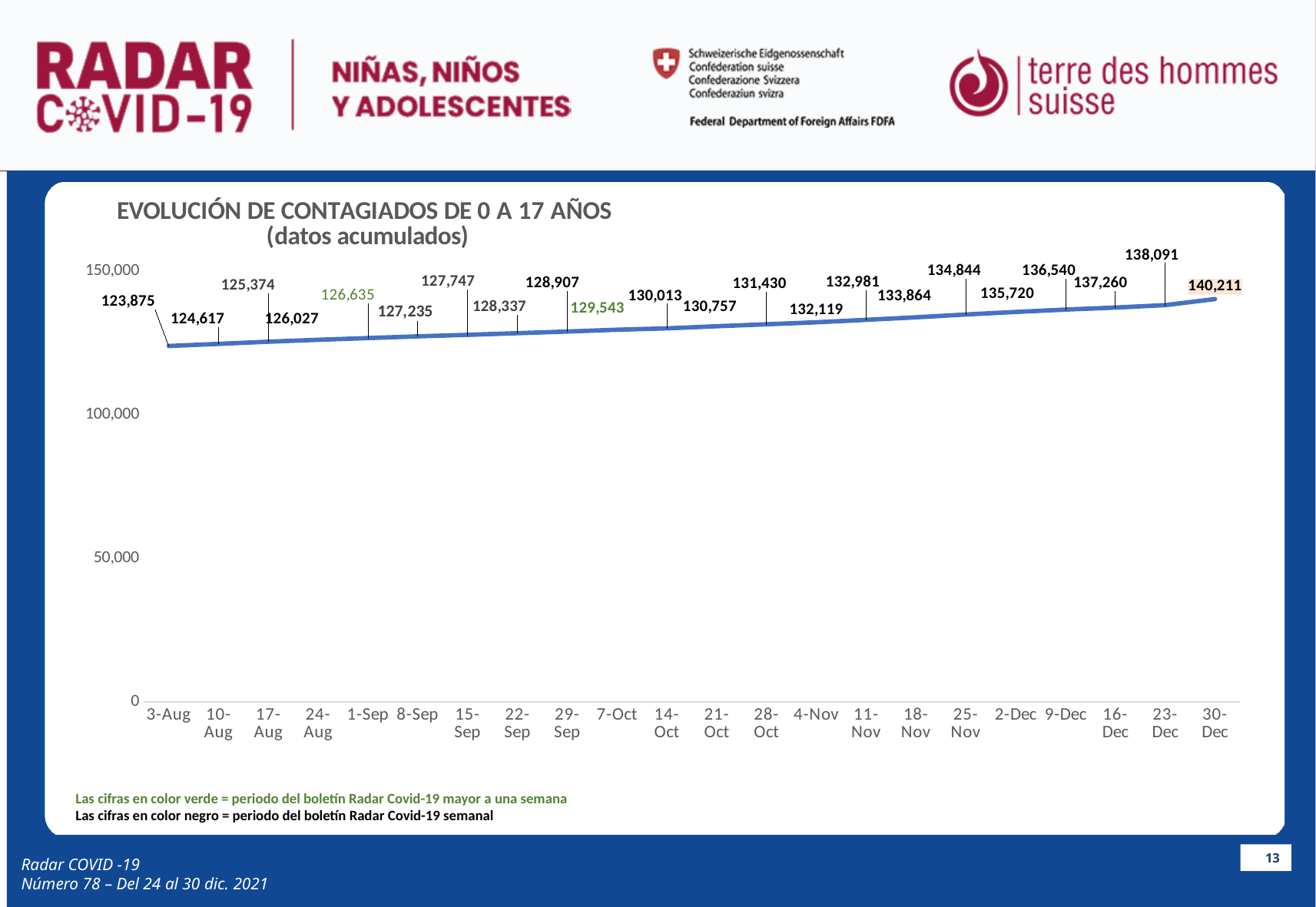
What is the value shown for 7-Oct? 129,543 What is the title of the chart? EVOLUCIÓN DE CONTAGIADOS DE 0 A 17 AÑOS (datos acumulados) What is the cumulative value shown for 30-Dec? 140,211 Which date has the lowest value on the chart? 3-Aug Which is larger, the value for 11-Nov or the value for 18-Nov? 18-Nov How many dates are plotted along the x axis? 22 Is the value for 30-Dec greater or less than 150,000? less What is the difference between the values for 30-Dec and 3-Aug? 16,336 Which date has the highest value on the chart? 30-Dec What kind of chart is shown on the slide? Line chart What is the difference between the values for 30-Dec and 23-Dec? 2,120 What is the value shown for 3-Aug? 123,875